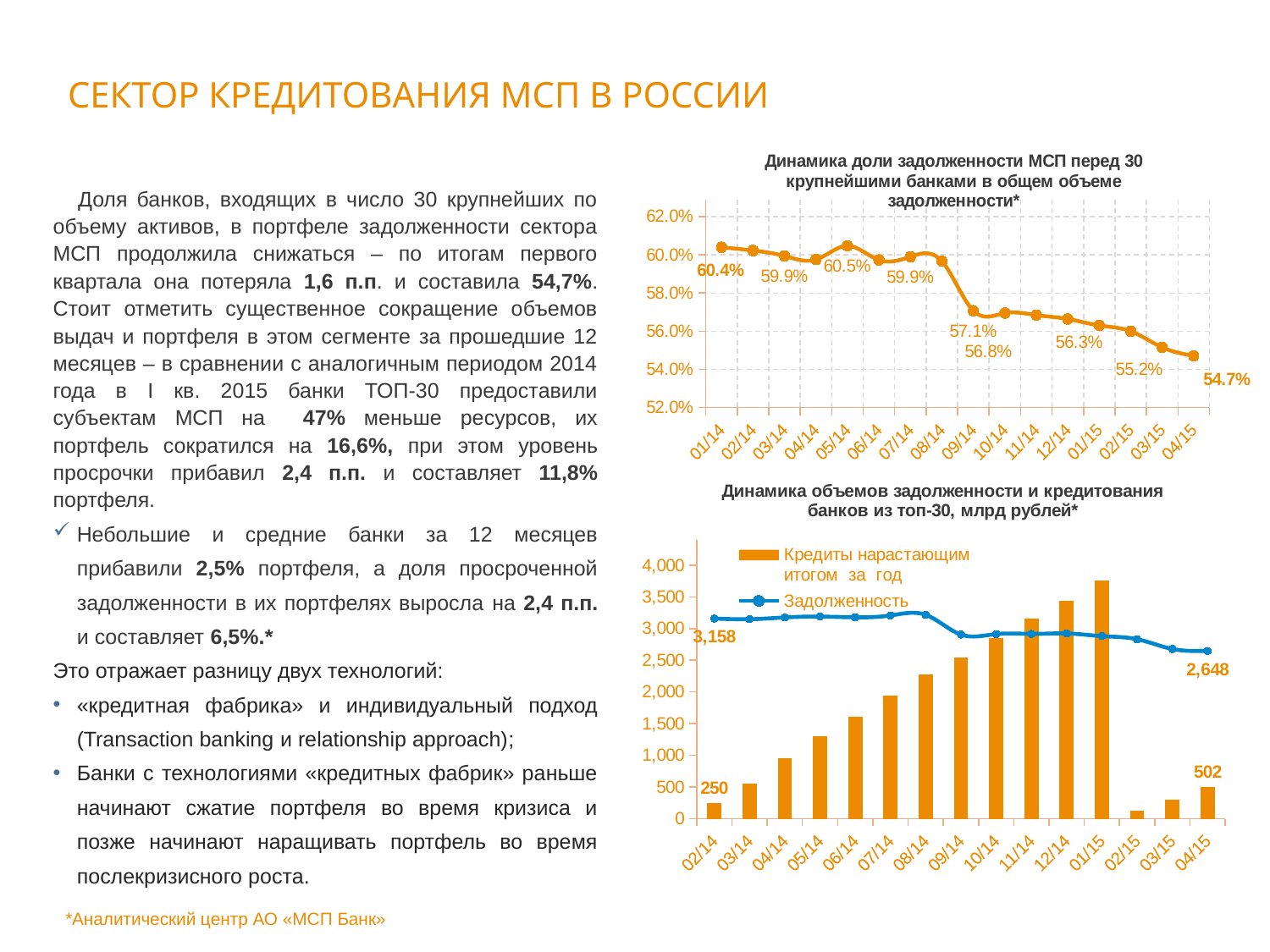
In the top chart (share of SME debt to the 30 largest banks), what is the value for 04/15? 54.7% In the bottom chart (volumes of debt and lending of top-30 banks), what is the value of 'Задолженность' for 02/14? 3,158 In the top chart (share of SME debt to the 30 largest banks), which period has the lowest value? 04/15 In the top chart (share of SME debt to the 30 largest banks), do the values generally rise or fall from 01/14 to 04/15? Fall In the bottom chart (volumes of debt and lending of top-30 banks), is the 'Кредиты нарастающим итогом за год' bar for 12/14 greater or less than 3,000? greater How many series does the legend of the bottom chart ('Динамика объемов задолженности и кредитования банков из топ-30') list? 2 In the top chart (share of SME debt to the 30 largest banks), what is the value for 01/14? 60.4% In the bottom chart (volumes of debt and lending of top-30 banks), which period has the tallest 'Кредиты нарастающим итогом за год' bar? 01/15 In the bottom chart (volumes of debt and lending of top-30 banks), what is the value of 'Кредиты нарастающим итогом за год' for 04/15? 502 What kind of chart is the top chart, 'Динамика доли задолженности МСП перед 30 крупнейшими банками в общем объеме задолженности'? Line chart In the bottom chart (volumes of debt and lending of top-30 banks), what is the difference between the 'Задолженность' values for 02/14 and 04/15? 510 In the top chart (share of SME debt to the 30 largest banks), by how many percentage points is the 01/14 value higher than the 04/15 value? 5.7 percentage points